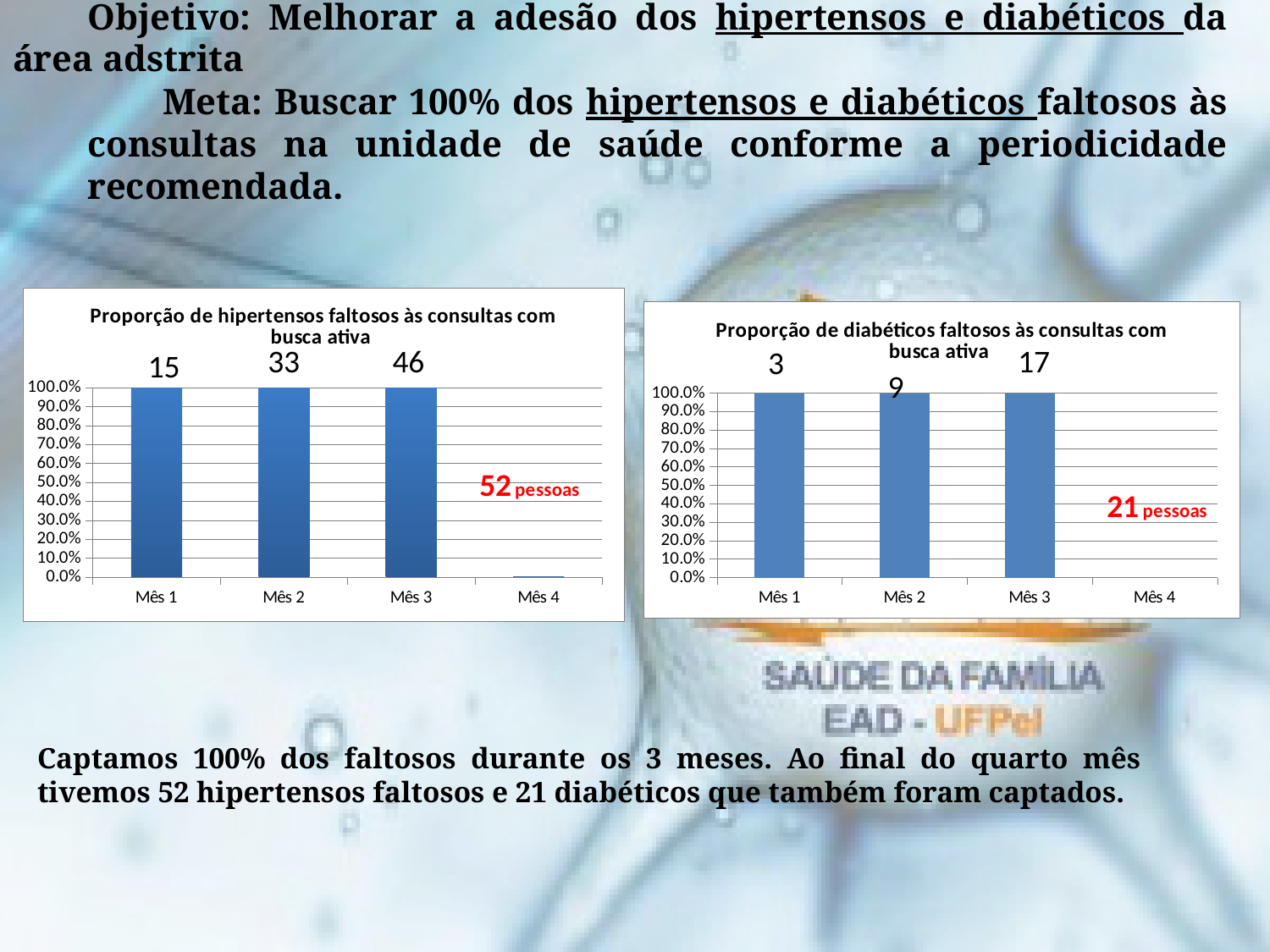
In the right chart, 'Proporção de diabéticos faltosos às consultas com busca ativa', what number is printed above the bar for Mês 3? 17 What kind of chart is the right chart, 'Proporção de diabéticos faltosos às consultas com busca ativa'? Bar chart In the left chart, 'Proporção de hipertensos faltosos às consultas com busca ativa', what number is printed above the bar for Mês 3? 46 In the left chart, 'Proporção de hipertensos faltosos às consultas com busca ativa', what value does the bar for Mês 1 reach? 100.0% In the right chart, 'Proporção de diabéticos faltosos às consultas com busca ativa', which month has the lowest bar? Mês 4 How many categories are shown on the x axis of the left chart, 'Proporção de hipertensos faltosos às consultas com busca ativa'? 4 In the left chart, 'Proporção de hipertensos faltosos às consultas com busca ativa', which month has the lowest bar? Mês 4 What red annotation text is shown inside the right chart, 'Proporção de diabéticos faltosos às consultas com busca ativa'? 21 pessoas What kind of chart is the left chart, 'Proporção de hipertensos faltosos às consultas com busca ativa'? Bar chart In the left chart, 'Proporção de hipertensos faltosos às consultas com busca ativa', what number is printed above the bar for Mês 2? 33 In the right chart, 'Proporção de diabéticos faltosos às consultas com busca ativa', what value does the bar for Mês 2 reach? 100.0% In the right chart, 'Proporção de diabéticos faltosos às consultas com busca ativa', what number is printed above the bar for Mês 1? 3